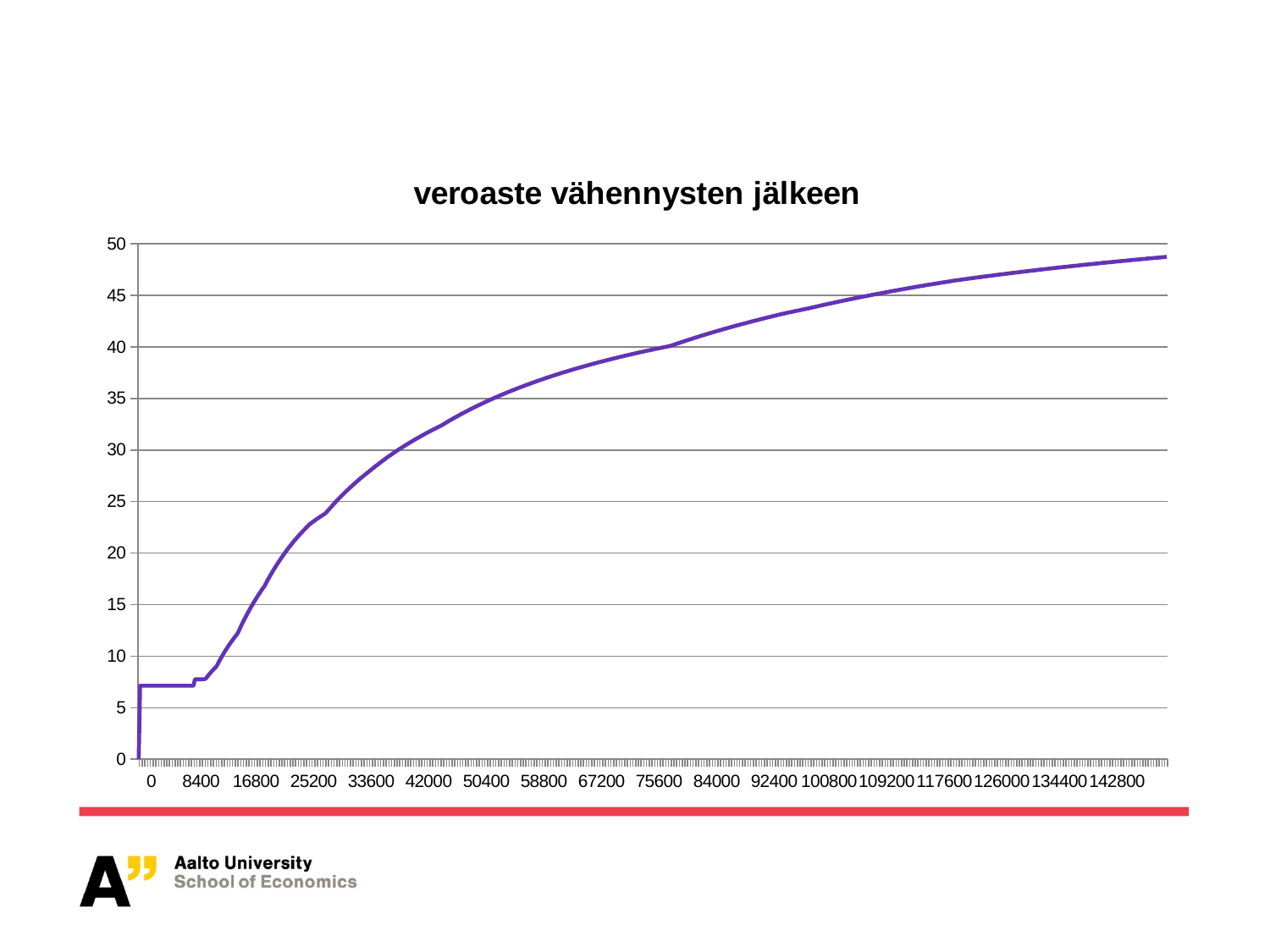
Is the value at x = 8400 greater or less than 10? less Is the value at x = 50400 greater or less than 30? greater What is the title of the chart? veroaste vähennysten jälkeen Is the value at x = 100800 greater or less than 40? greater What kind of chart is shown on the slide? line chart What colour is the plotted line? purple Do the values generally rise or fall as the x axis increases? rise